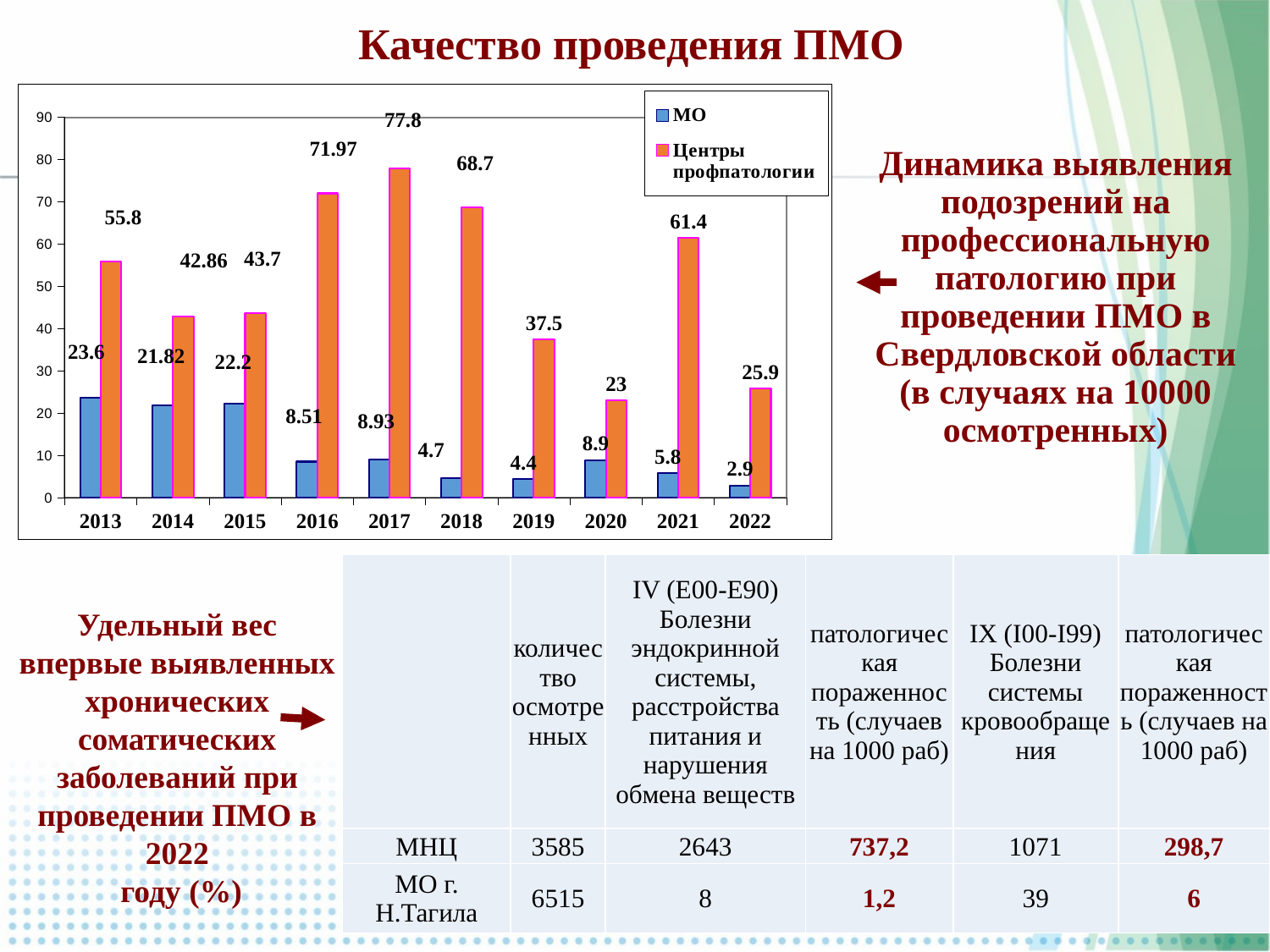
Which is larger in 2021: the value for МО or for Центры профпатологии? Центры профпатологии In which year is the value for Центры профпатологии highest? 2017 What kind of chart is shown on the slide? bar chart Is the value for Центры профпатологии in 2016 greater or less than 70? greater In which year is the value for МО lowest? 2022 What is the value for Центры профпатологии in 2017? 77.8 How many series does the chart legend list? 2 What is the difference between Центры профпатологии and МО in 2013? 32.2 What is the value for МО in 2014? 21.82 In which year is the value for Центры профпатологии lowest? 2020 How many years are shown on the x axis of the chart? 10 What is the value for Центры профпатологии in 2022? 25.9